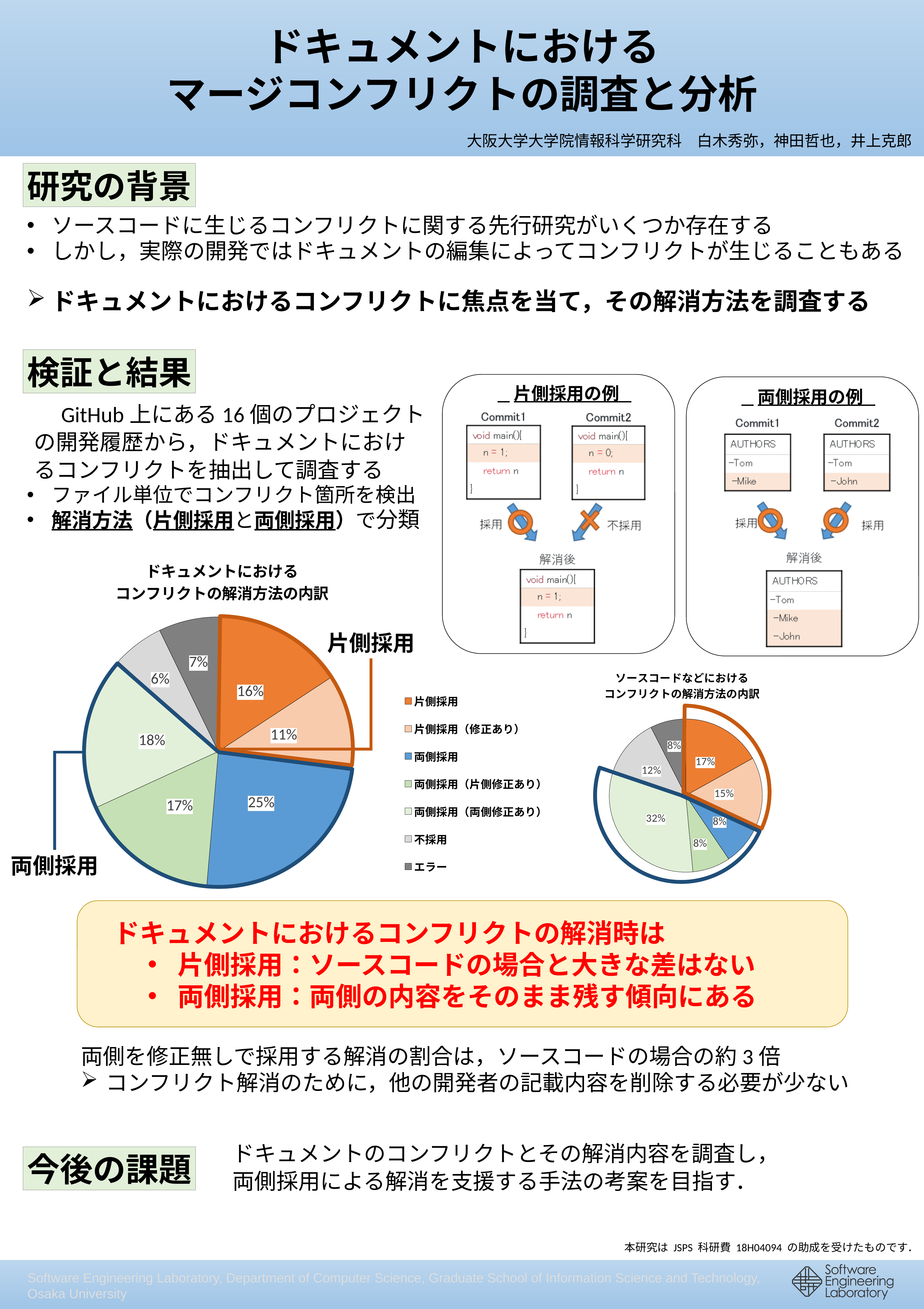
How many categories does the shared legend list for the pie charts? 7 In the pie chart titled ドキュメントにおけるコンフリクトの解消方法の内訳, what percentage is shown for 両側採用? 25% In the pie chart titled ソースコードなどにおけるコンフリクトの解消方法の内訳, which category has the largest share? 両側採用（両側修正あり） In the pie chart titled ソースコードなどにおけるコンフリクトの解消方法の内訳, what is the combined share of 片側採用 and 片側採用（修正あり）? 32% In the pie chart titled ドキュメントにおけるコンフリクトの解消方法の内訳, which category has the largest share? 両側採用 In the pie chart titled ドキュメントにおけるコンフリクトの解消方法の内訳, what percentage is shown for 片側採用? 16% In the pie chart titled ドキュメントにおけるコンフリクトの解消方法の内訳, what is the difference between the shares of 両側採用 and 片側採用? 9% What kind of chart is ドキュメントにおけるコンフリクトの解消方法の内訳? Pie chart In the pie chart titled ドキュメントにおけるコンフリクトの解消方法の内訳, which category has the smallest share? 不採用 In the pie chart titled ソースコードなどにおけるコンフリクトの解消方法の内訳, what percentage is shown for 不採用? 12% In the pie chart titled ソースコードなどにおけるコンフリクトの解消方法の内訳, what percentage is shown for 両側採用（両側修正あり）? 32% Which is larger: the 両側採用 share in the ドキュメント pie chart or the 両側採用 share in the ソースコード pie chart? ドキュメント pie chart